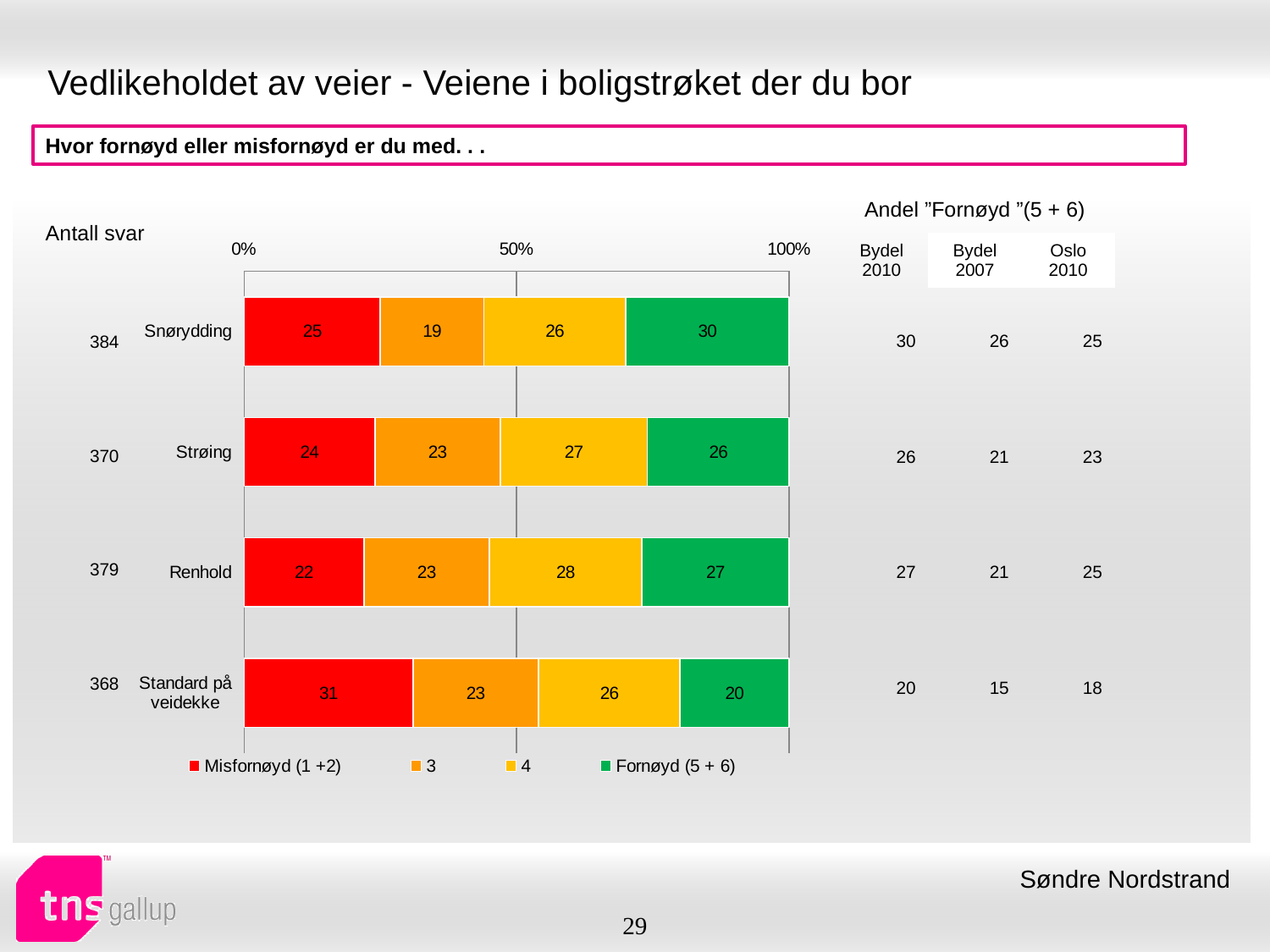
Which category has the highest Fornøyd (5 + 6) value? Snørydding What is the value of the '4' segment for Renhold? 28 What kind of chart is shown on the slide? stacked bar chart Which is larger: the Fornøyd (5 + 6) value for Strøing or for Renhold? Renhold What is the value of the '3' segment for Strøing? 23 What is the value of the Misfornøyd (1 +2) segment for Standard på veidekke? 31 What is the value of the Fornøyd (5 + 6) segment for Snørydding? 30 Which category has the lowest Fornøyd (5 + 6) value? Standard på veidekke How many series does the legend list? 4 What is the difference between the Misfornøyd (1 +2) values for Standard på veidekke and Renhold? 9 How many categories are plotted in the chart? 4 Which series is shown in red in the chart? Misfornøyd (1 +2)